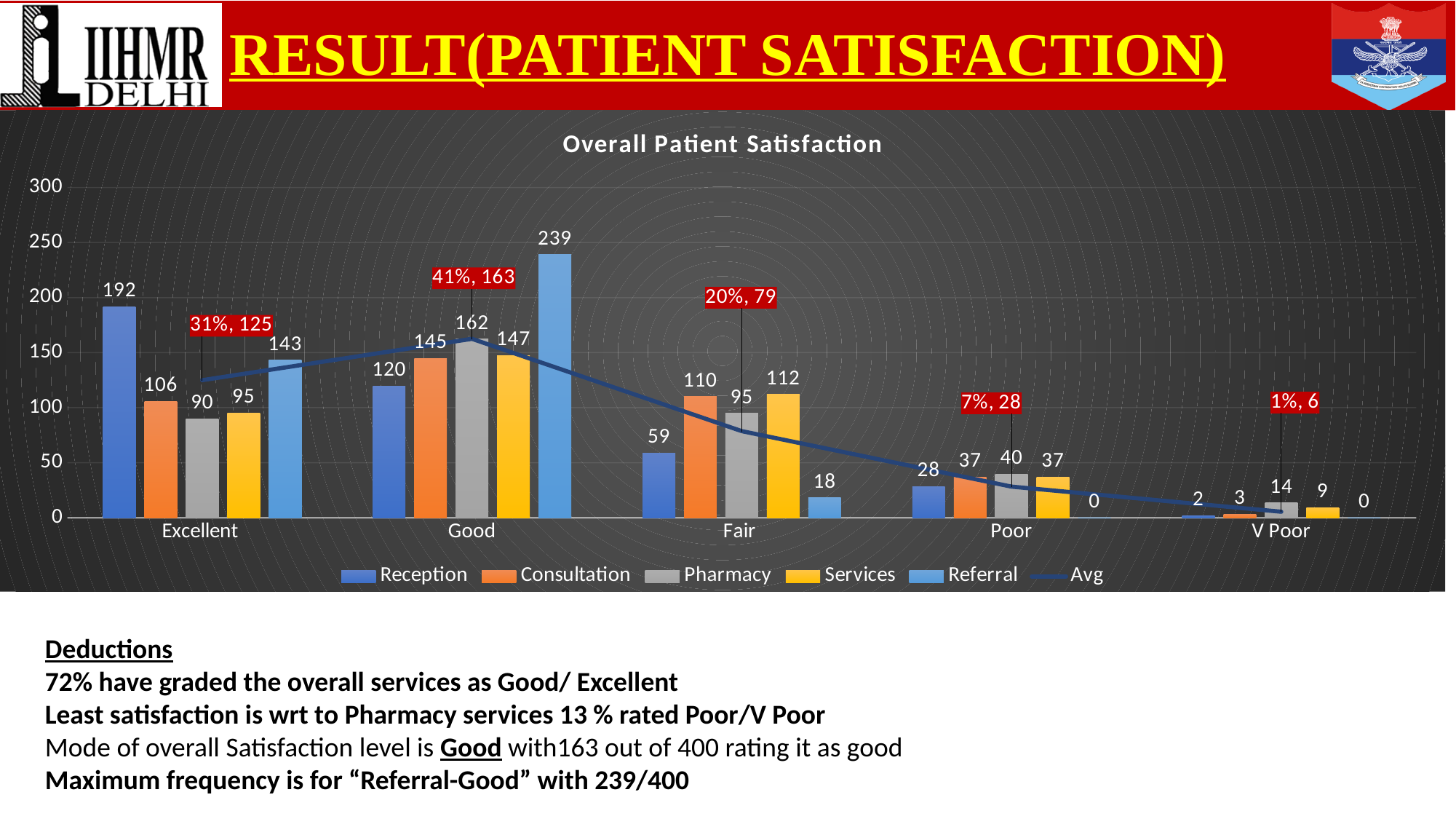
What is the value for Reception in the Excellent category? 192 What is the difference between the Referral value and the Reception value in the Good category? 119 What is the value for Pharmacy in the V Poor category? 14 Does the Avg line rise or fall from Good to V Poor? Fall Which is larger in the Excellent category: Consultation or Pharmacy? Consultation What is the Avg data label shown for the Fair category? 20%, 79 How many categories are shown on the x axis? 5 What is the title of the chart? Overall Patient Satisfaction Which series has the lowest value in the Fair category? Referral Which series has the highest value in the Good category? Referral What is the value for Referral in the Good category? 239 How many series does the legend list? 6